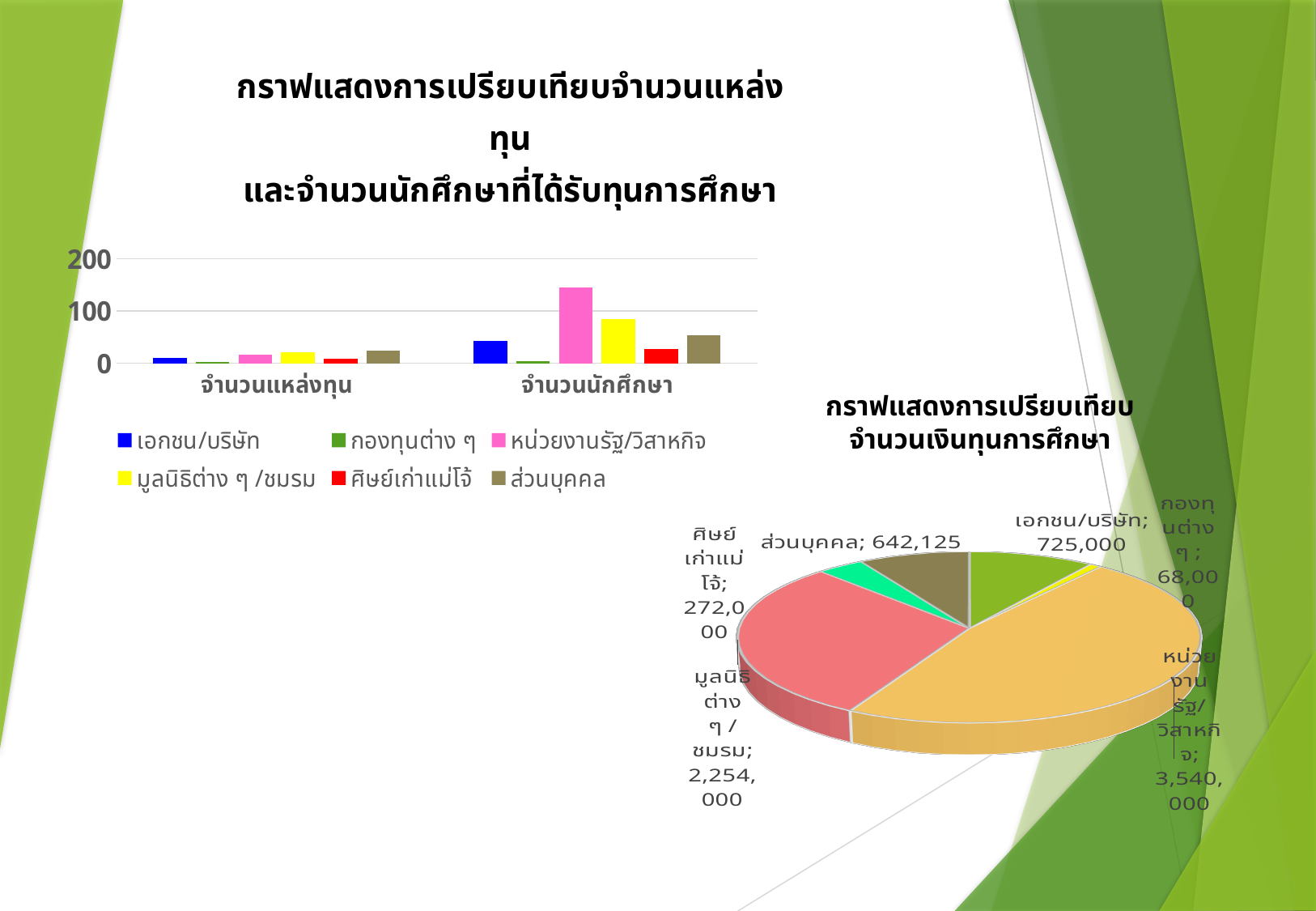
In the pie chart titled กราฟแสดงการเปรียบเทียบจำนวนเงินทุนการศึกษา, what is the value for มูลนิธิต่าง ๆ /ชมรม? 2,254,000 In the pie chart titled กราฟแสดงการเปรียบเทียบจำนวนเงินทุนการศึกษา, which category has the smallest value? กองทุนต่าง ๆ In the pie chart titled กราฟแสดงการเปรียบเทียบจำนวนเงินทุนการศึกษา, which category has the largest value? หน่วยงานรัฐ/วิสาหกิจ How many series does the legend of the bar chart in the top left list? 6 How many slices does the pie chart titled กราฟแสดงการเปรียบเทียบจำนวนเงินทุนการศึกษา have? 6 In the pie chart titled กราฟแสดงการเปรียบเทียบจำนวนเงินทุนการศึกษา, what is the difference between หน่วยงานรัฐ/วิสาหกิจ and มูลนิธิต่าง ๆ /ชมรม? 1,286,000 In the pie chart titled กราฟแสดงการเปรียบเทียบจำนวนเงินทุนการศึกษา, what is the value for หน่วยงานรัฐ/วิสาหกิจ? 3,540,000 In the pie chart titled กราฟแสดงการเปรียบเทียบจำนวนเงินทุนการศึกษา, which is larger: เอกชน/บริษัท or ศิษย์เก่าแม่โจ้? เอกชน/บริษัท In the pie chart titled กราฟแสดงการเปรียบเทียบจำนวนเงินทุนการศึกษา, what is the value for ส่วนบุคคล? 642,125 What kind of chart is the chart in the top left of the slide? Bar chart In the bar chart in the top left, which series has the tallest bar in the จำนวนนักศึกษา category? หน่วยงานรัฐ/วิสาหกิจ In the bar chart in the top left, is the value for หน่วยงานรัฐ/วิสาหกิจ in the จำนวนนักศึกษา category greater or less than 100? greater